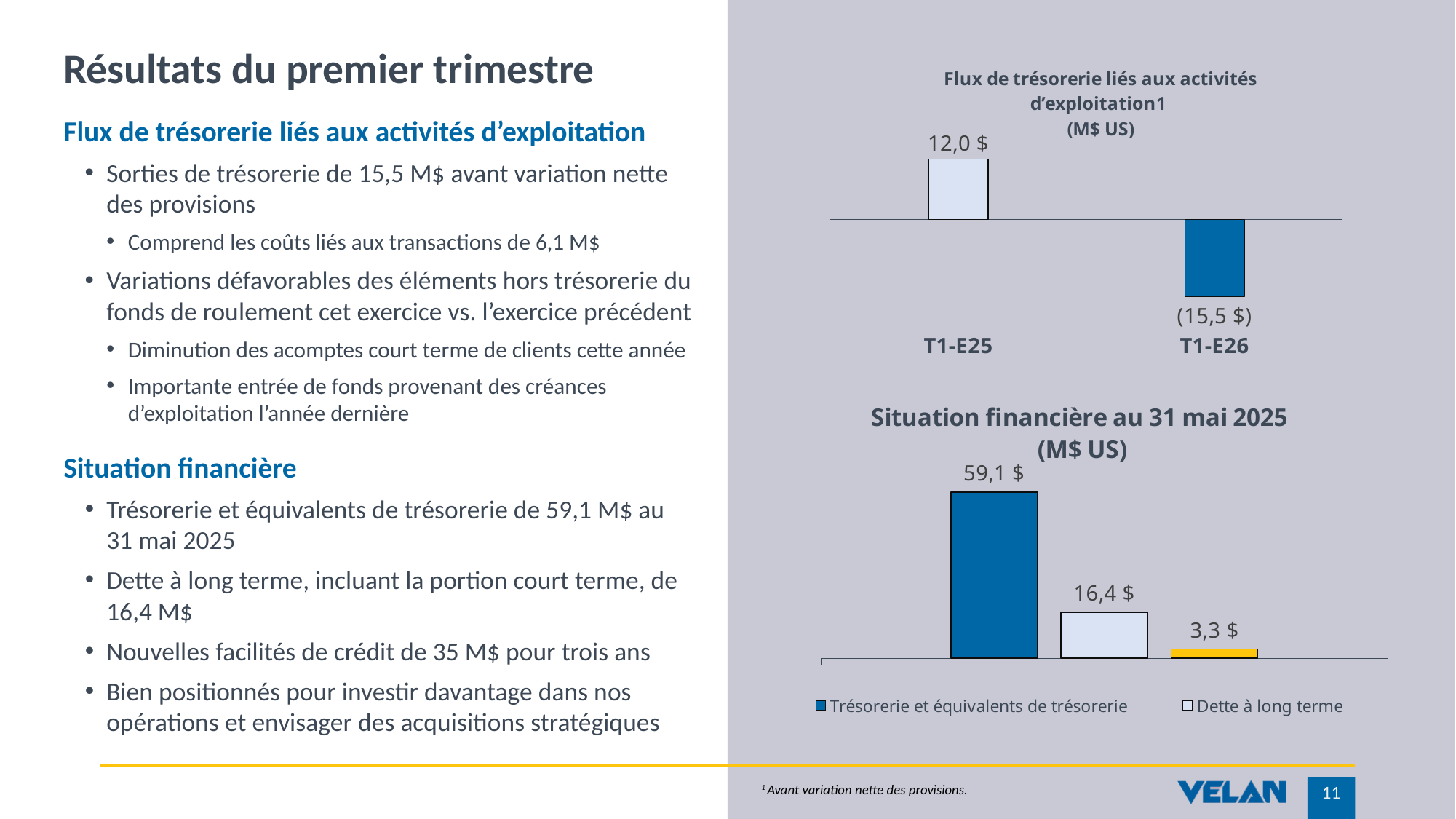
In the chart titled "Flux de trésorerie liés aux activités d'exploitation", which period has the higher value? T1-E25 In the chart titled "Flux de trésorerie liés aux activités d'exploitation", do the values rise or fall from T1-E25 to T1-E26? fall In the chart titled "Situation financière au 31 mai 2025", what is the value shown on the yellow bar? 3,3 $ In the chart titled "Situation financière au 31 mai 2025", what is the value for Trésorerie et équivalents de trésorerie? 59,1 $ In the chart titled "Flux de trésorerie liés aux activités d'exploitation", what is the value for T1-E26? (15,5 $) In the chart titled "Flux de trésorerie liés aux activités d'exploitation", what is the value for T1-E25? 12,0 $ What kind of chart is the chart titled "Flux de trésorerie liés aux activités d'exploitation"? bar chart In the chart titled "Situation financière au 31 mai 2025", what is the difference between Trésorerie et équivalents de trésorerie and Dette à long terme? 42,7 $ In the chart titled "Situation financière au 31 mai 2025", what is the value for Dette à long terme? 16,4 $ In the chart titled "Situation financière au 31 mai 2025", which bar has the highest value? Trésorerie et équivalents de trésorerie In the chart titled "Flux de trésorerie liés aux activités d'exploitation", how many periods are plotted? 2 In the chart titled "Situation financière au 31 mai 2025", how many entries does the legend list? 2